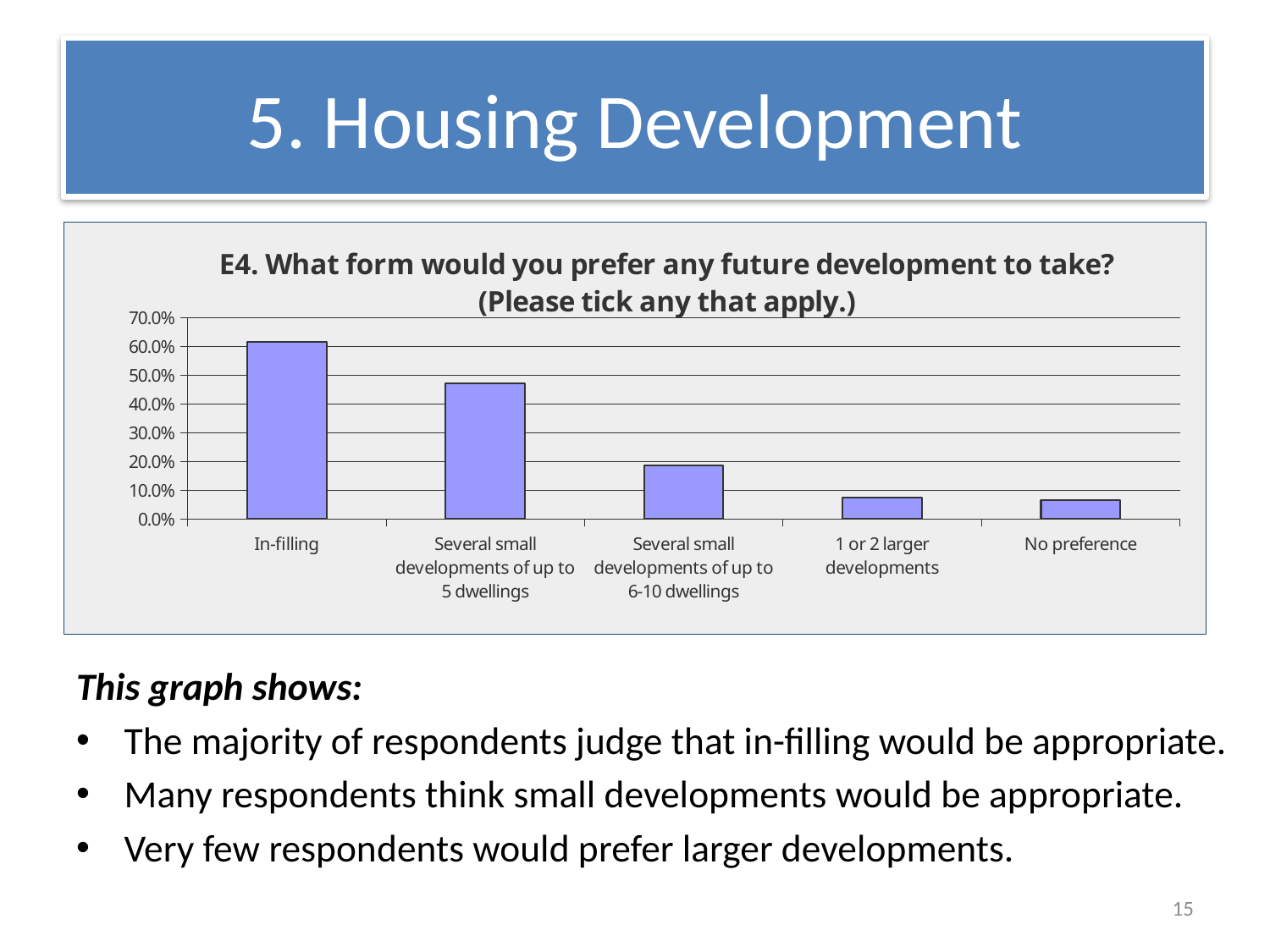
Is the value for In-filling greater or less than 60.0%? greater Is the value for No preference greater or less than 10.0%? less How many categories are shown on the x axis of the chart? 5 Which category has the highest value in the chart? In-filling Is the value for Several small developments of up to 5 dwellings greater or less than 50.0%? less Which is larger, the value for In-filling or the value for Several small developments of up to 5 dwellings? In-filling Do the values rise or fall moving from left to right along the x axis? fall What kind of chart is shown on the slide? bar chart What is the title of the chart? E4. What form would you prefer any future development to take? (Please tick any that apply.)